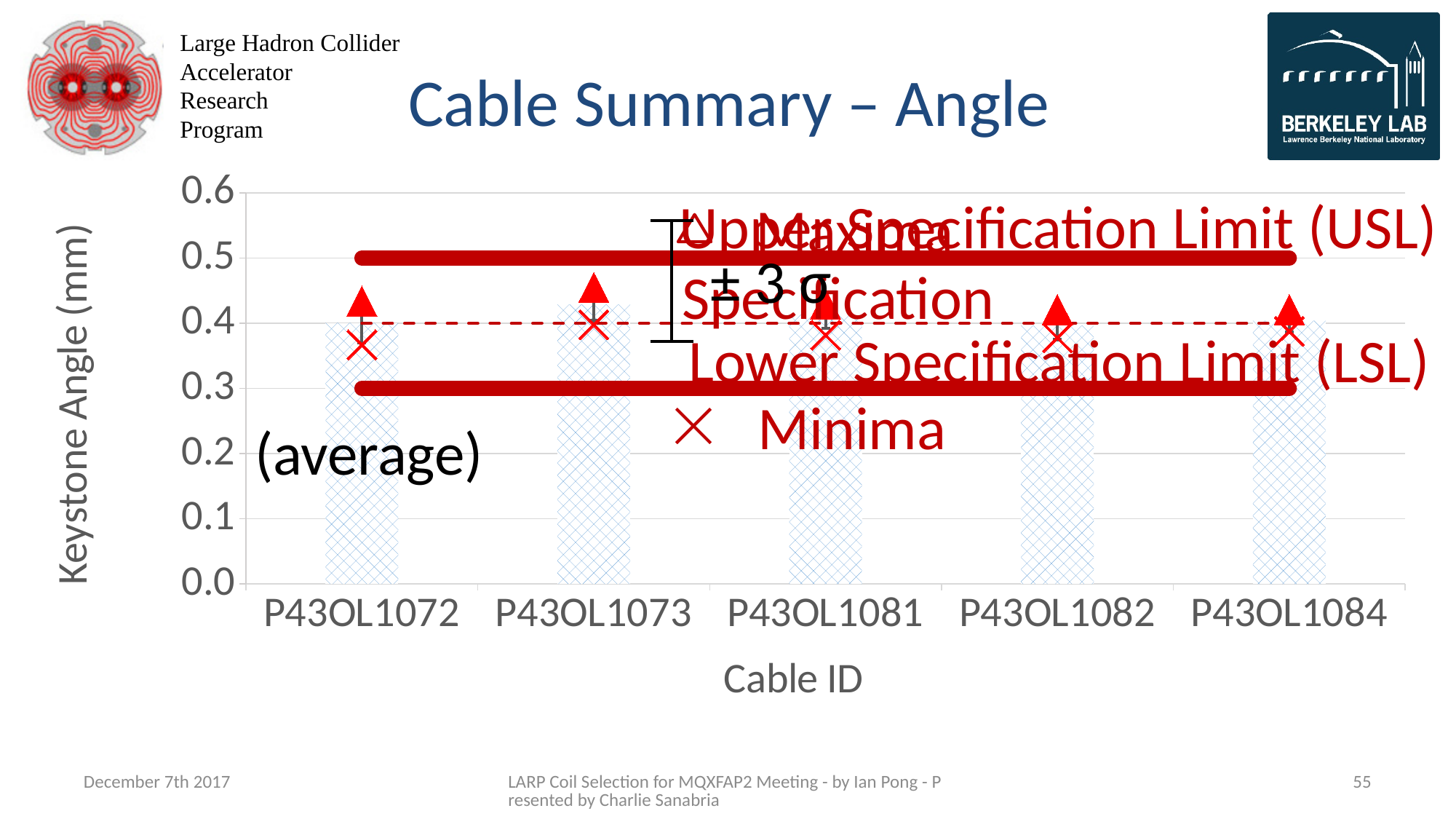
Is the average keystone angle for P43OL1072 greater or less than 0.3? greater How many cable IDs are shown on the x axis of the chart? 5 Which cable ID has the highest maximum keystone angle? P43OL1073 At what keystone angle value is the Upper Specification Limit (USL) line drawn? 0.5 Is the maximum keystone angle for P43OL1082 greater or less than 0.4? greater Is the minimum keystone angle for P43OL1084 greater or less than 0.3? greater What type of chart is shown on the slide? bar chart At what keystone angle value is the Lower Specification Limit (LSL) line drawn? 0.3 What is the title of the chart on the slide? Cable Summary – Angle What is the y-axis label of the chart? Keystone Angle (mm)